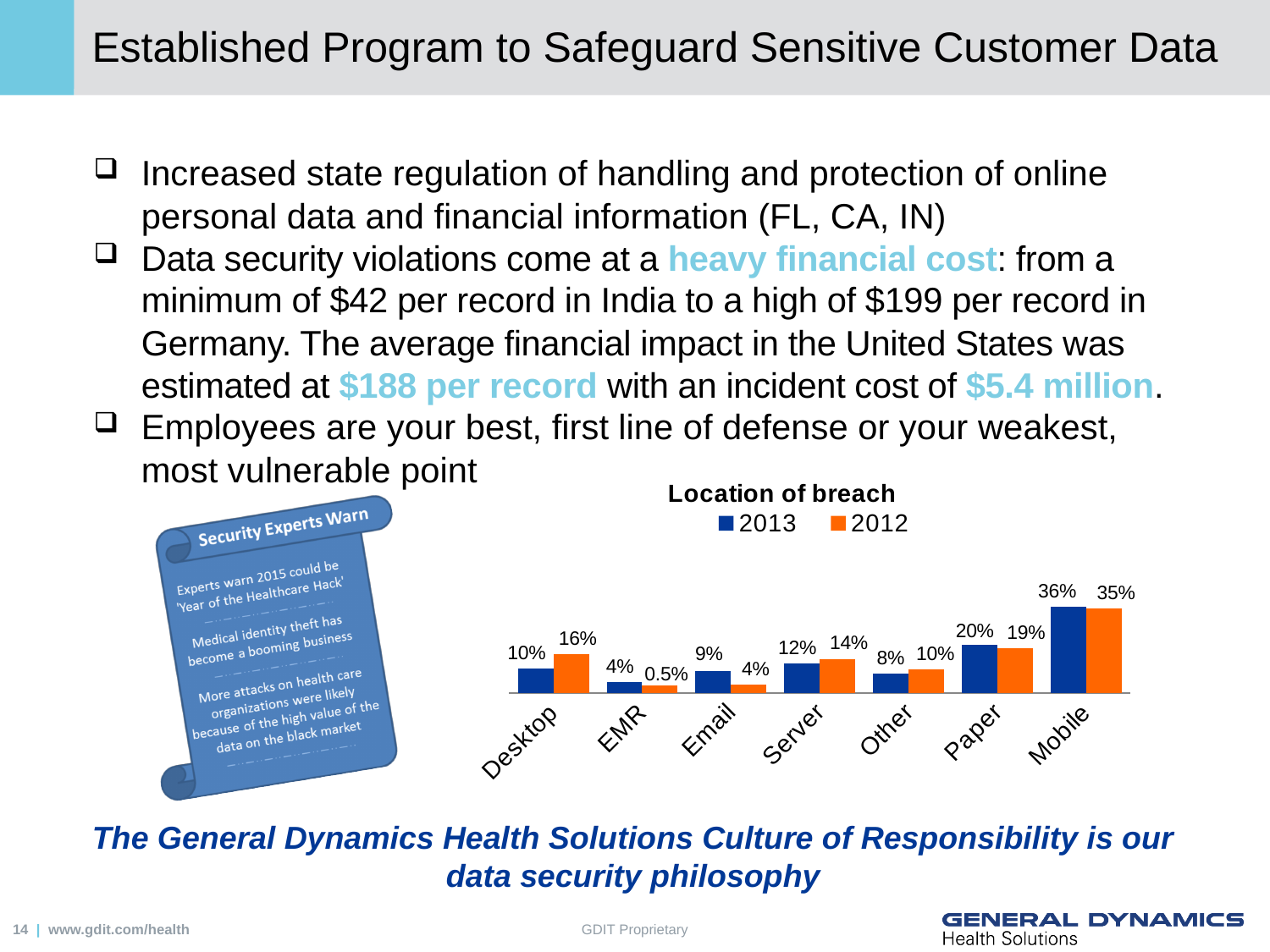
Which category has the lowest 2012 value? EMR How many series does the legend list? 2 Which is larger for Server, the 2013 value or the 2012 value? 2012 What is the difference between the 2012 values for Desktop and Paper? 3% What is the 2013 value for Mobile? 36% What is the difference between the 2013 and 2012 values for Email? 5% What kind of chart is shown on the slide? bar chart How many breach location categories are shown on the x axis? 7 Which category has the highest 2013 value? Mobile What is the title of the chart? Location of breach What is the 2012 value for Desktop? 16% What is the 2012 value for EMR? 0.5%